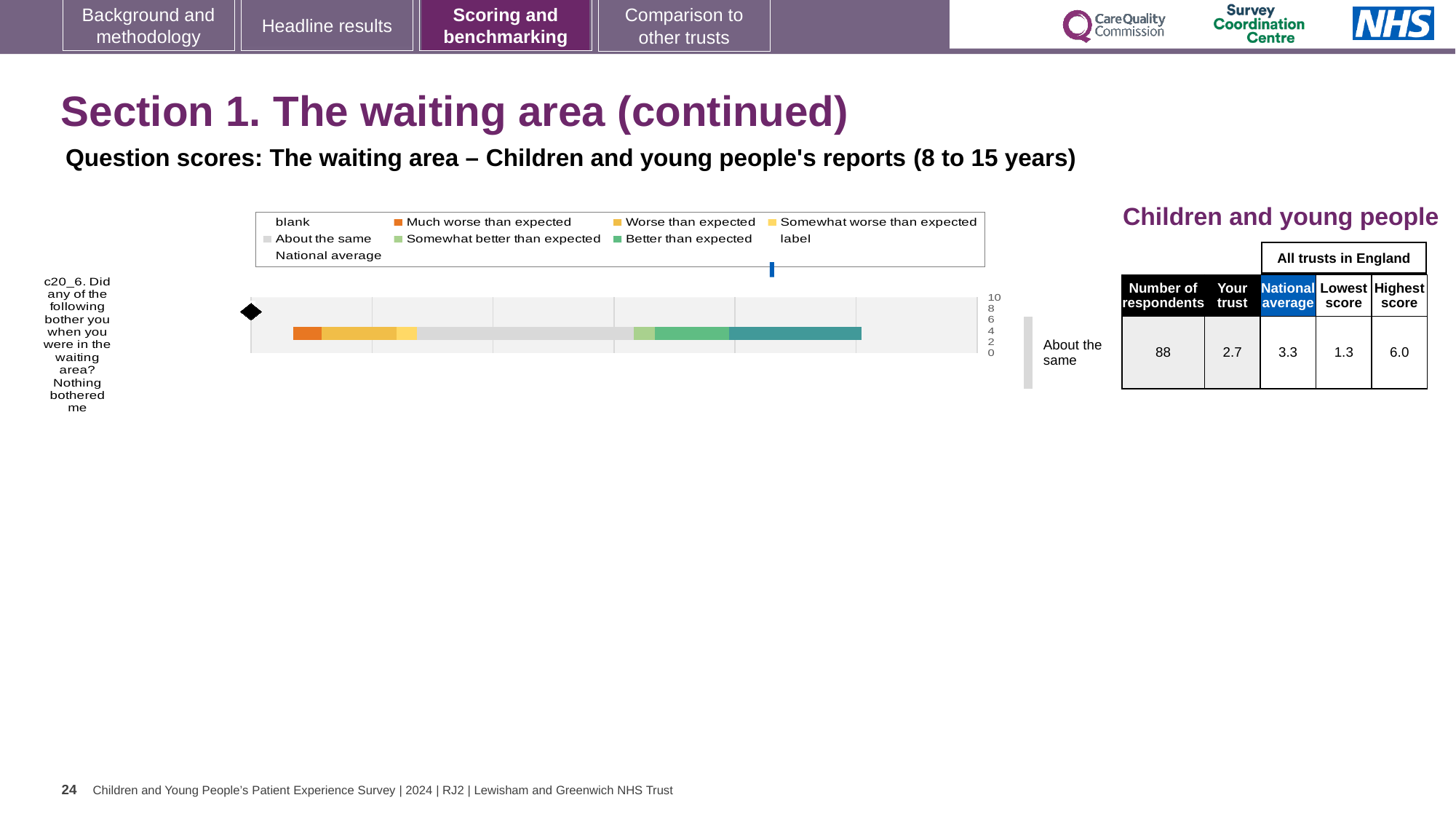
Which is larger for question c20_6: the 'Your trust' score or the National average score? National average In the table next to the chart, what is the Lowest score among all trusts in England for question c20_6? 1.3 In the table next to the chart, what is the Number of respondents for question c20_6? 88 In the table next to the chart, what is the National average score for question c20_6? 3.3 In the table next to the chart, what is the 'Your trust' score for question c20_6? 2.7 How many entries does the chart legend list? 9 What is the highest tick value shown on the chart's numeric axis? 10 What rating label is shown to the right of the bar chart for the trust's result? About the same In the table next to the chart, what is the Highest score among all trusts in England for question c20_6? 6.0 What kind of chart is shown on the slide? Stacked bar chart How many question categories are plotted in the bar chart? 1 Which question code is shown as the category label of the bar chart? c20_6